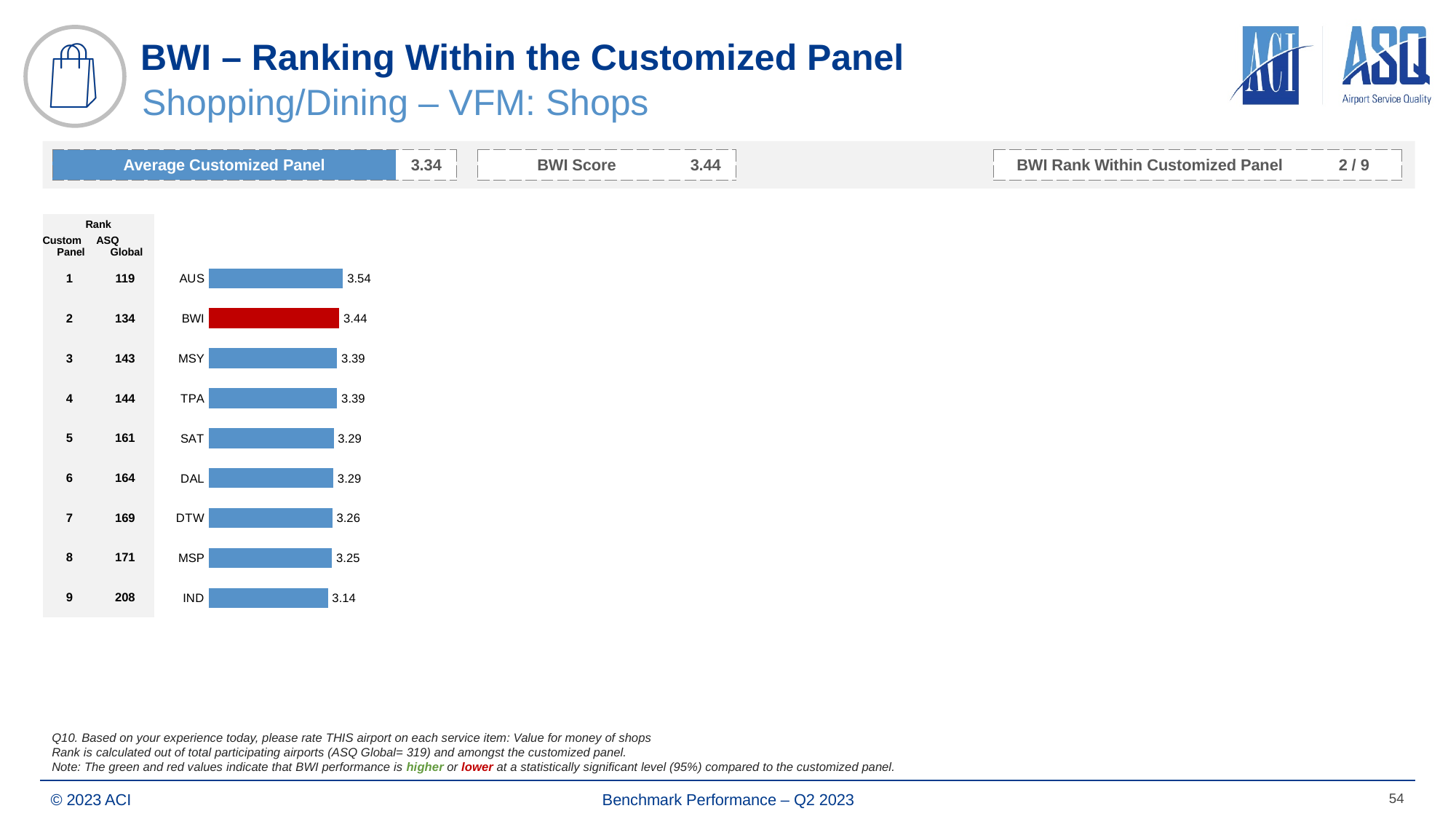
Which is larger, the value for MSP or the value for SAT? SAT Which airport's bar is coloured red? BWI What is the value for DTW? 3.26 What is the value for AUS? 3.54 How many airports are shown in the chart? 9 What is the value for BWI? 3.44 What is the difference between the values for BWI and IND? 0.30 What kind of chart is shown on the slide? Bar chart Which airport has the highest value? AUS What is the difference between the values for AUS and BWI? 0.10 What is the value for IND? 3.14 Which airport has the lowest value? IND